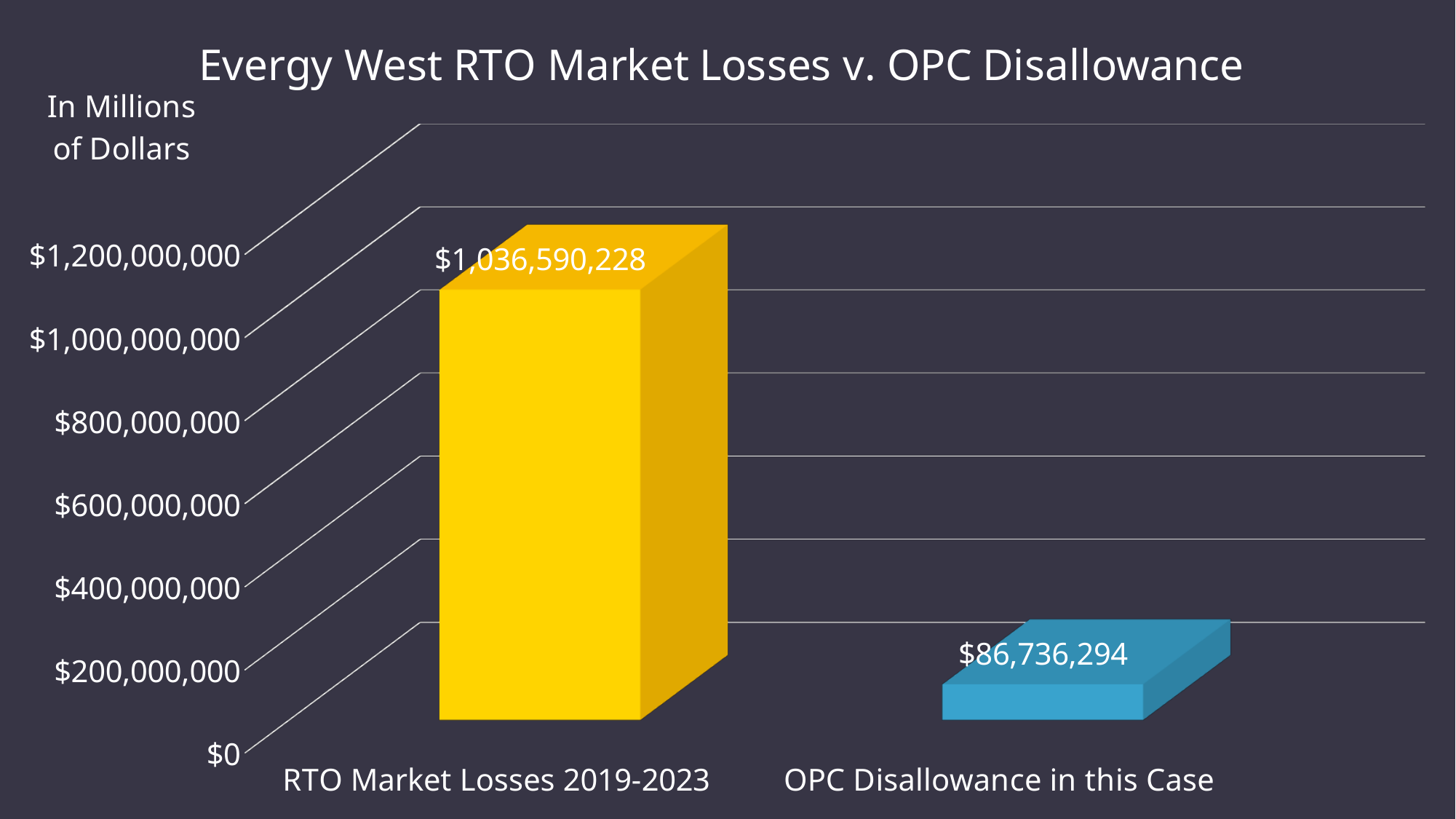
What kind of chart is shown on the slide? bar chart What is the title of the chart? Evergy West RTO Market Losses v. OPC Disallowance What is the difference between RTO Market Losses 2019-2023 and OPC Disallowance in this Case? $949,853,934 Is the value for RTO Market Losses 2019-2023 greater or less than $1,000,000,000? greater What colour is the bar for OPC Disallowance in this Case? blue Is the value for OPC Disallowance in this Case greater or less than $200,000,000? less What is the value for OPC Disallowance in this Case? $86,736,294 Which category has the lowest value? OPC Disallowance in this Case What is the value for RTO Market Losses 2019-2023? $1,036,590,228 How many categories are shown in the chart? 2 Which is larger, RTO Market Losses 2019-2023 or OPC Disallowance in this Case? RTO Market Losses 2019-2023 Which category has the highest value? RTO Market Losses 2019-2023